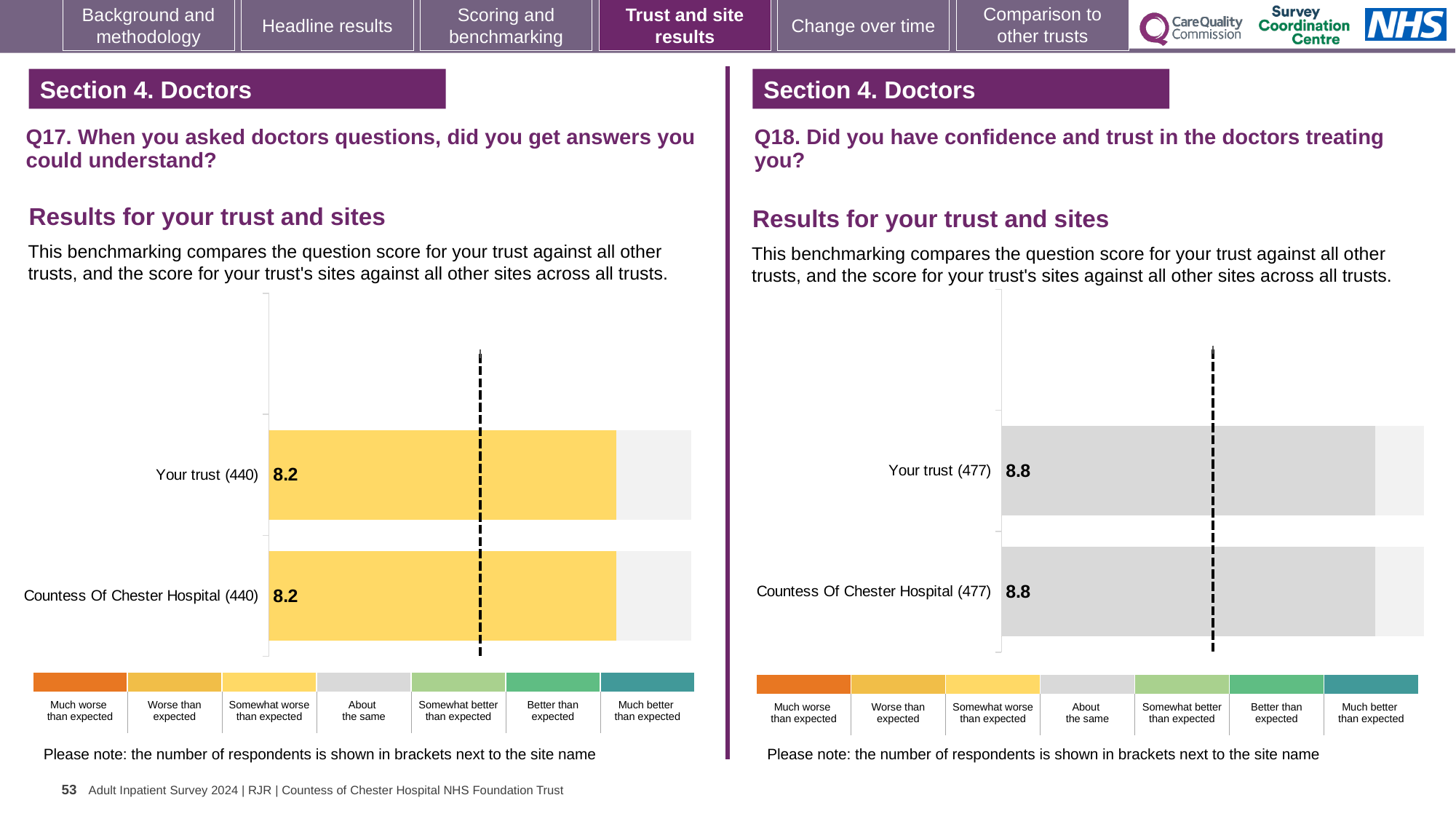
On the Q17 chart (left), how many respondents are shown in brackets for Your trust? 440 On the Q17 chart (left), what is the difference between the Your trust score and the Countess Of Chester Hospital score? 0 On the Q18 chart (right), what is the difference between the Your trust score and the Countess Of Chester Hospital score? 0 How many bars are plotted on the Q17 chart (left)? 2 According to the colour key, which benchmark category does the grey bar colour on the Q18 chart (right) represent? About the same On the Q17 chart (left), what is the score for Countess Of Chester Hospital? 8.2 On the Q17 chart (left), what is the score for Your trust? 8.2 What kind of chart is used for the Q17 results (left)? Bar chart How many bars are plotted on the Q18 chart (right)? 2 On the Q18 chart (right), how many respondents are shown in brackets for Countess Of Chester Hospital? 477 On the Q18 chart (right), what is the score for Countess Of Chester Hospital? 8.8 On the Q18 chart (right), what is the score for Your trust? 8.8